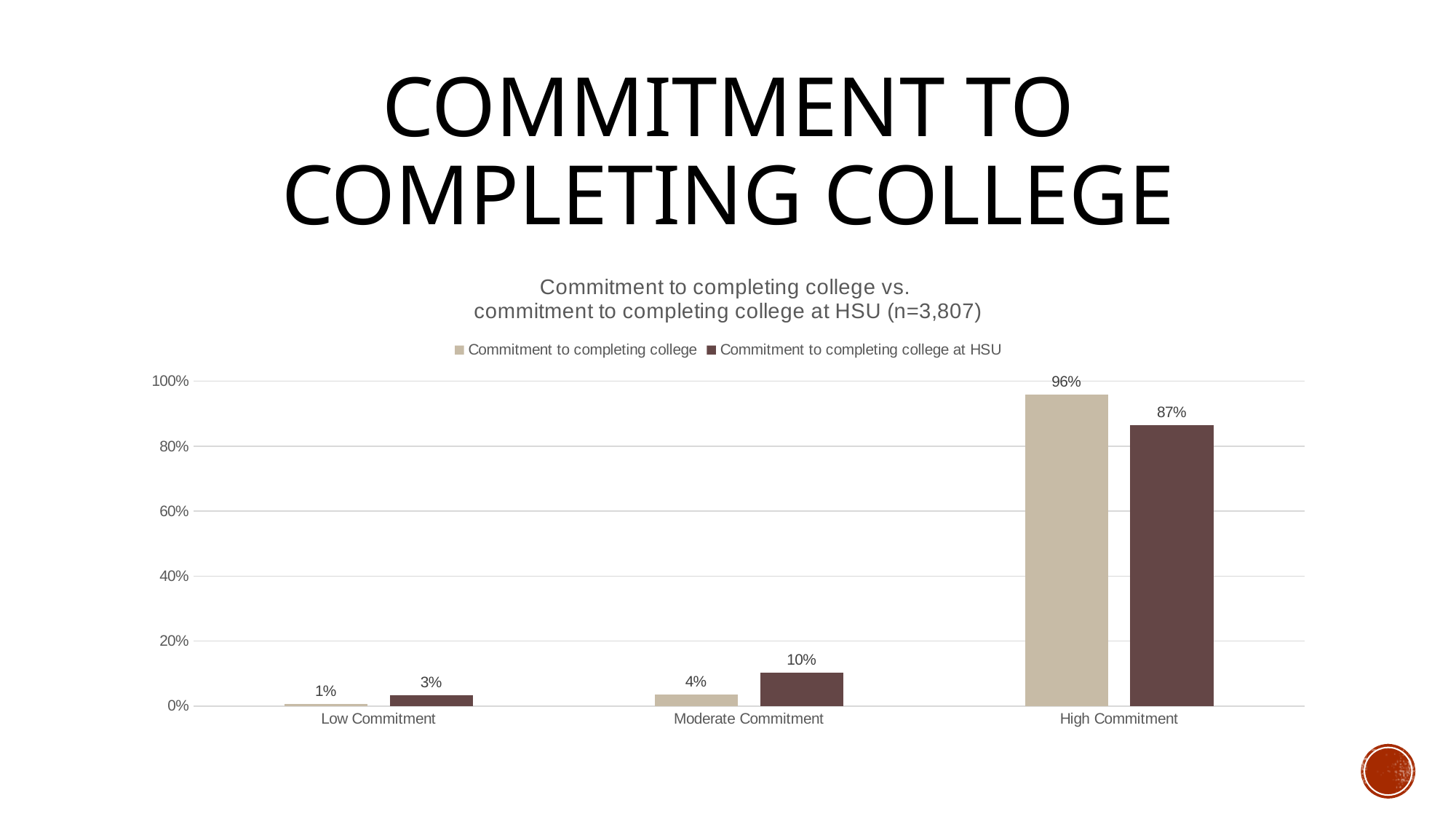
Which category has the highest value for Commitment to completing college at HSU? High Commitment What is the difference between Commitment to completing college and Commitment to completing college at HSU in the High Commitment category? 9% What kind of chart is shown on the slide? Bar chart How many categories are shown on the x axis? 3 What is the value for Commitment to completing college in the High Commitment category? 96% Is the value for Commitment to completing college at HSU in the High Commitment category greater or less than 80%? greater How many series does the legend list? 2 What is the sample size (n) given in the chart title? 3,807 In the Moderate Commitment category, which series has the larger value? Commitment to completing college at HSU Which category has the lowest value for Commitment to completing college? Low Commitment What is the value for Commitment to completing college at HSU in the Low Commitment category? 3% What is the value for Commitment to completing college at HSU in the Moderate Commitment category? 10%